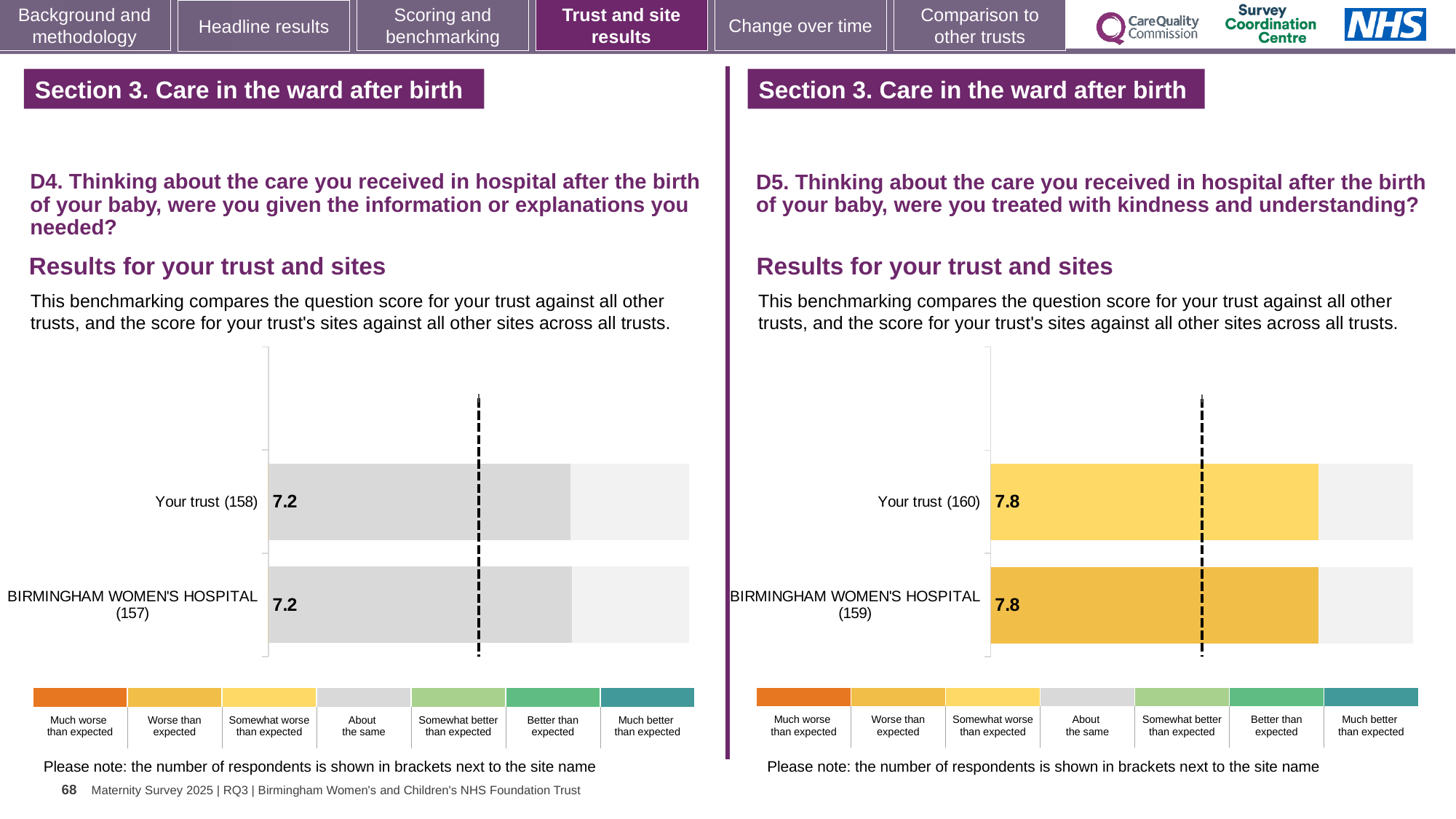
In the D5 chart on the right, how many respondents are shown in brackets for BIRMINGHAM WOMEN'S HOSPITAL? 159 In the D5 chart on the right, which benchmarking category does the colour of the Your trust bar correspond to in the legend? Somewhat worse than expected In the D5 chart on the right, what is the score for BIRMINGHAM WOMEN'S HOSPITAL? 7.8 In the D5 chart on the right, what is the difference between the score for Your trust and the score for BIRMINGHAM WOMEN'S HOSPITAL? 0 In the D4 chart on the left, what is the score for BIRMINGHAM WOMEN'S HOSPITAL? 7.2 What type of chart is used for the D4 results on the left? Bar chart In the D4 chart on the left, what is the difference between the score for Your trust and the score for BIRMINGHAM WOMEN'S HOSPITAL? 0 In the D5 chart on the right, what is the score for Your trust? 7.8 In the D4 chart on the left, how many respondents are shown in brackets for Your trust? 158 In the D4 chart on the left, what is the score for Your trust? 7.2 How many bars are plotted in the D4 chart on the left? 2 How many bars are plotted in the D5 chart on the right? 2